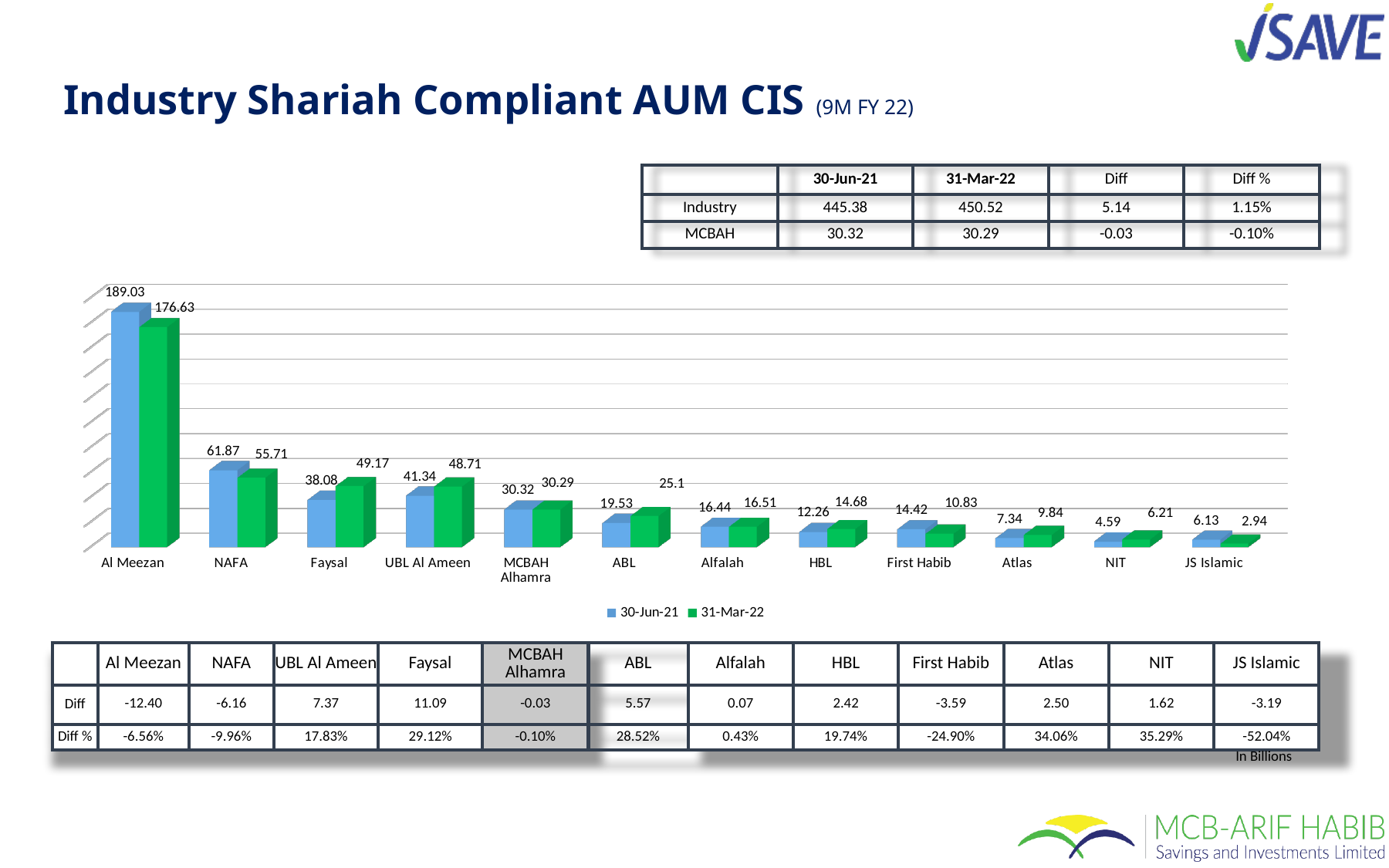
Which category has the lowest 31-Mar-22 value? JS Islamic What is the difference between the 30-Jun-21 and 31-Mar-22 values for Al Meezan? 12.40 What is the 30-Jun-21 value for Al Meezan? 189.03 What is the 31-Mar-22 value for ABL? 25.1 Which category has the lowest 30-Jun-21 value? NIT Which category has the highest 31-Mar-22 value? Al Meezan How many series does the chart legend list? 2 What is the 31-Mar-22 value for Faysal? 49.17 What is the 30-Jun-21 value for MCBAH Alhamra? 30.32 Which is larger for UBL Al Ameen: the 30-Jun-21 value or the 31-Mar-22 value? 31-Mar-22 What kind of chart is shown on the slide? Bar chart How many categories are shown on the x axis of the chart? 12